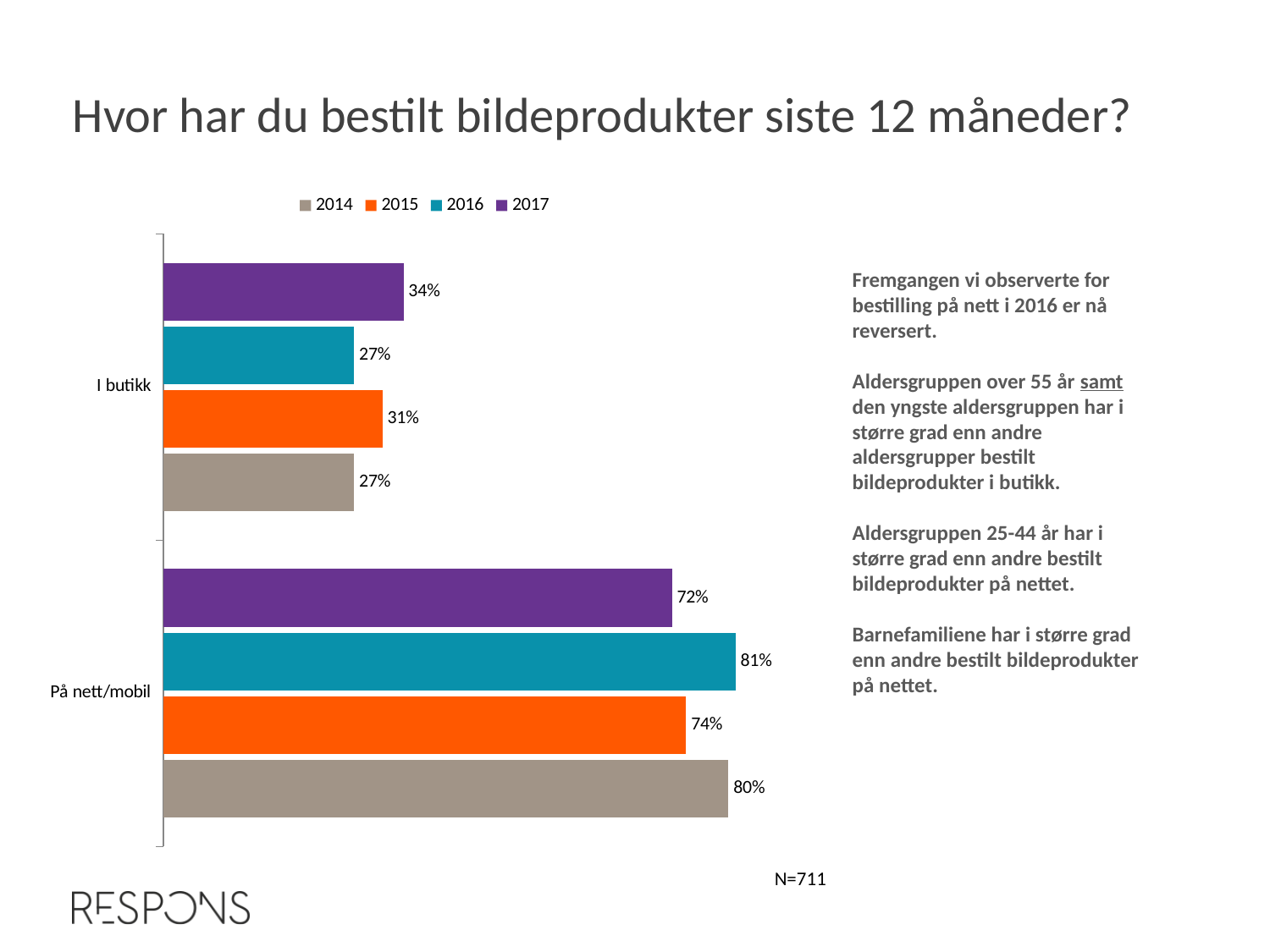
What is the value for 2016 in the 'På nett/mobil' category? 81% How many categories are shown on the chart? 2 What is the value for 2015 in the 'I butikk' category? 31% What is the value for 2017 in the 'I butikk' category? 34% What is the difference between the 2016 and 2017 values in the 'På nett/mobil' category? 9% Which is larger in the 'I butikk' category: the 2015 value or the 2017 value? 2017 How many series does the legend list? 4 Which year has the lowest value in the 'På nett/mobil' category? 2017 Which year has the highest value in the 'I butikk' category? 2017 Which year has the highest value in the 'På nett/mobil' category? 2016 What is the value for 2014 in the 'På nett/mobil' category? 80% What kind of chart is shown on the slide? Bar chart